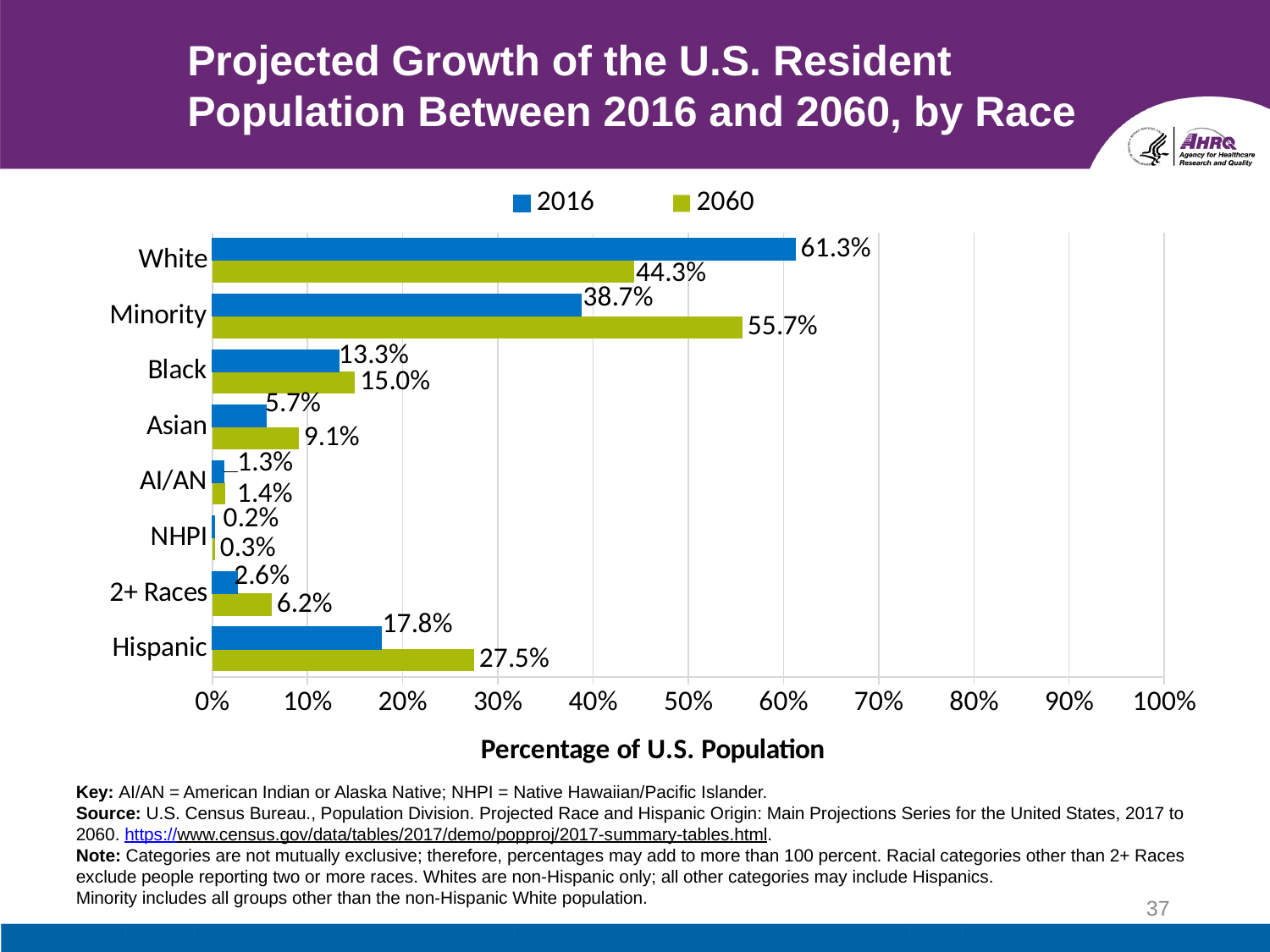
How many race categories are shown on the chart? 8 What is the 2060 value for Minority? 55.7% What kind of chart is shown on the slide? Bar chart Which is larger, the 2060 value for Black or the 2060 value for Asian? 2060 value for Black What is the 2016 value for White? 61.3% What is the 2060 value for Hispanic? 27.5% What is the difference between the 2016 and 2060 values for White? 17.0% What is the difference between the 2060 and 2016 values for Hispanic? 9.7% Which category has the highest 2016 value? White Which category has the lowest 2060 value? NHPI What is the label of the horizontal axis? Percentage of U.S. Population How many series does the legend list? 2